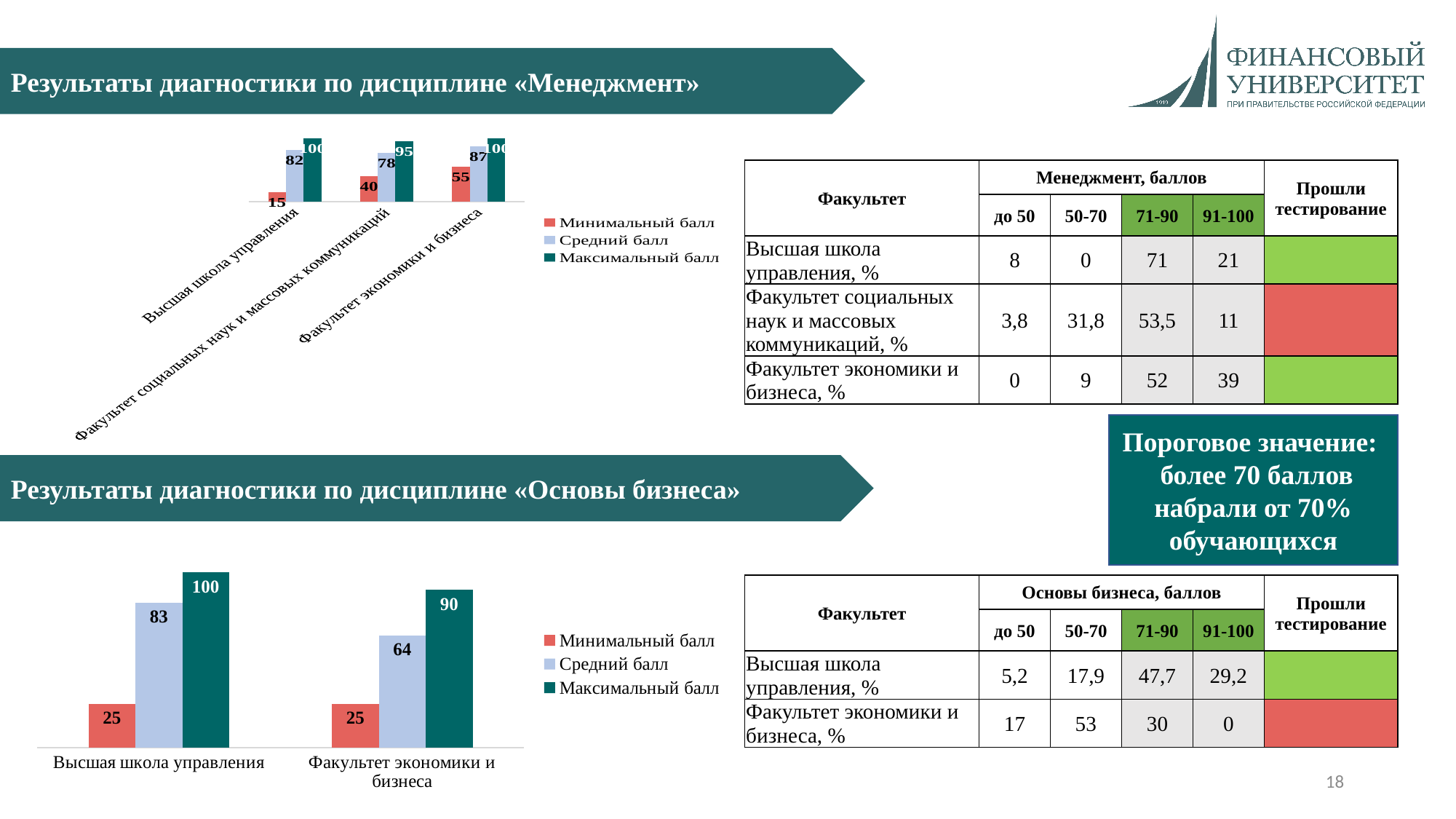
In the bottom chart (Основы бизнеса), which faculty has the higher Средний балл? Высшая школа управления In the bottom chart (Основы бизнеса), how many series does the legend list? 3 What type of chart is the bottom chart (Основы бизнеса)? Bar chart In the top chart (Менеджмент), how many faculties are shown on the x axis? 3 In the top chart (Менеджмент), what is the Минимальный балл for Факультет экономики и бизнеса? 55 In the bottom chart (Основы бизнеса), what is the difference between the Средний балл of Высшая школа управления and Факультет экономики и бизнеса? 19 In the bottom chart (Основы бизнеса), what is the Максимальный балл for Высшая школа управления? 100 In the top chart (Менеджмент), what is the difference between the Максимальный балл and the Минимальный балл for Факультет социальных наук и массовых коммуникаций? 55 In the top chart (Менеджмент), what is the Средний балл for Высшая школа управления? 82 In the bottom chart (Основы бизнеса), what is the Средний балл for Факультет экономики и бизнеса? 64 In the top chart (Менеджмент), which faculty has the lowest Минимальный балл? Высшая школа управления In the top chart (Менеджмент), which colour represents Максимальный балл in the legend? Dark teal (green)